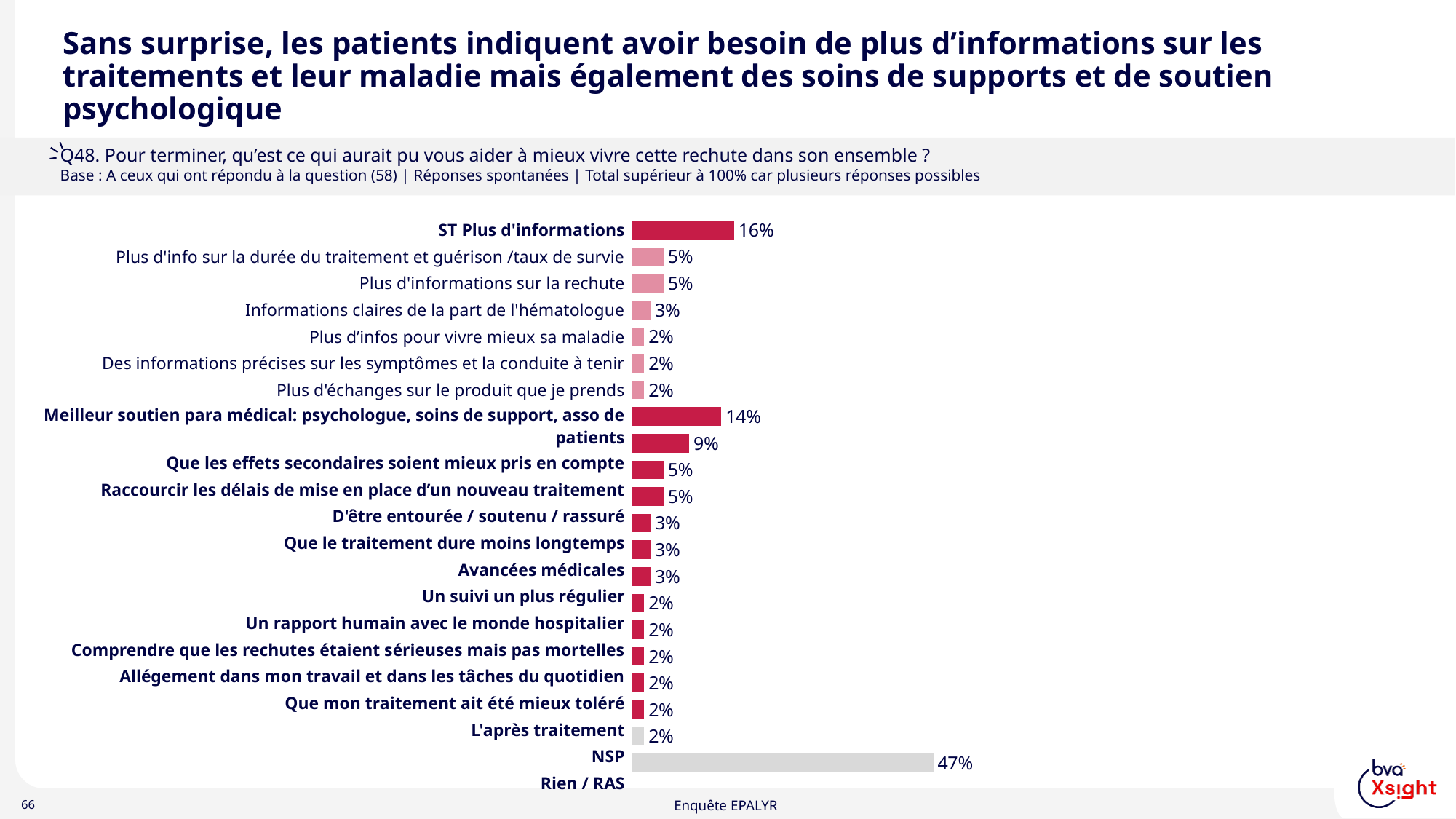
What is the value for "Meilleur soutien para médical: psychologue, soins de support, asso de patients"? 14% How many bars are plotted in the chart? 21 What is the value for "Plus d'informations sur la rechute"? 5% What is the value for "ST Plus d'informations"? 16% What kind of chart is shown on the slide? bar chart What is the value for "Plus d'échanges sur le produit que je prends"? 2% What is the value for "Informations claires de la part de l'hématologue"? 3% What is the difference between the values for "Plus d'info sur la durée du traitement et guérison /taux de survie" and "Informations claires de la part de l'hématologue"? 2% What colour is the longest bar in the chart? grey What is the largest value shown in the chart? 47% Which is larger: the value for "Plus d'info sur la durée du traitement et guérison /taux de survie" or for "Plus d'infos pour vivre mieux sa maladie"? Plus d'info sur la durée du traitement et guérison /taux de survie What is the difference between the values for "ST Plus d'informations" and "Meilleur soutien para médical: psychologue, soins de support, asso de patients"? 2%